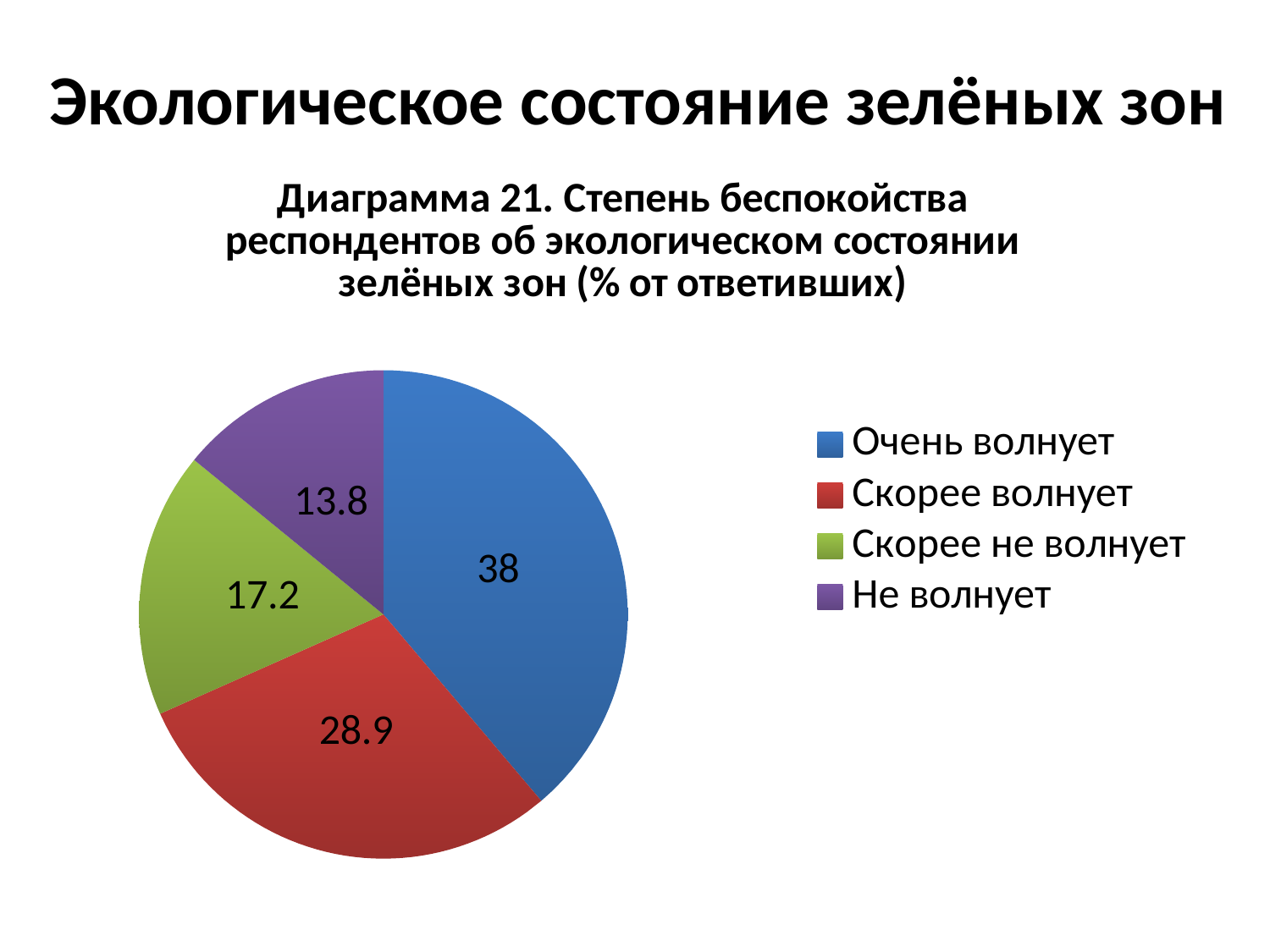
How many categories does the pie chart have? 4 What is the number of the diagram given in the chart title? 21 Which category has the smallest share of the pie? Не волнует Which is larger, the value for "Скорее не волнует" or the value for "Не волнует"? Скорее не волнует What is the difference between the values for "Очень волнует" and "Скорее волнует"? 9.1 What is the value for "Очень волнует"? 38 What colour is the slice for "Скорее волнует"? red What is the value for "Не волнует"? 13.8 What is the value for "Скорее волнует"? 28.9 What type of chart is shown on the slide? pie chart What is the value for "Скорее не волнует"? 17.2 Which category has the largest share of the pie? Очень волнует